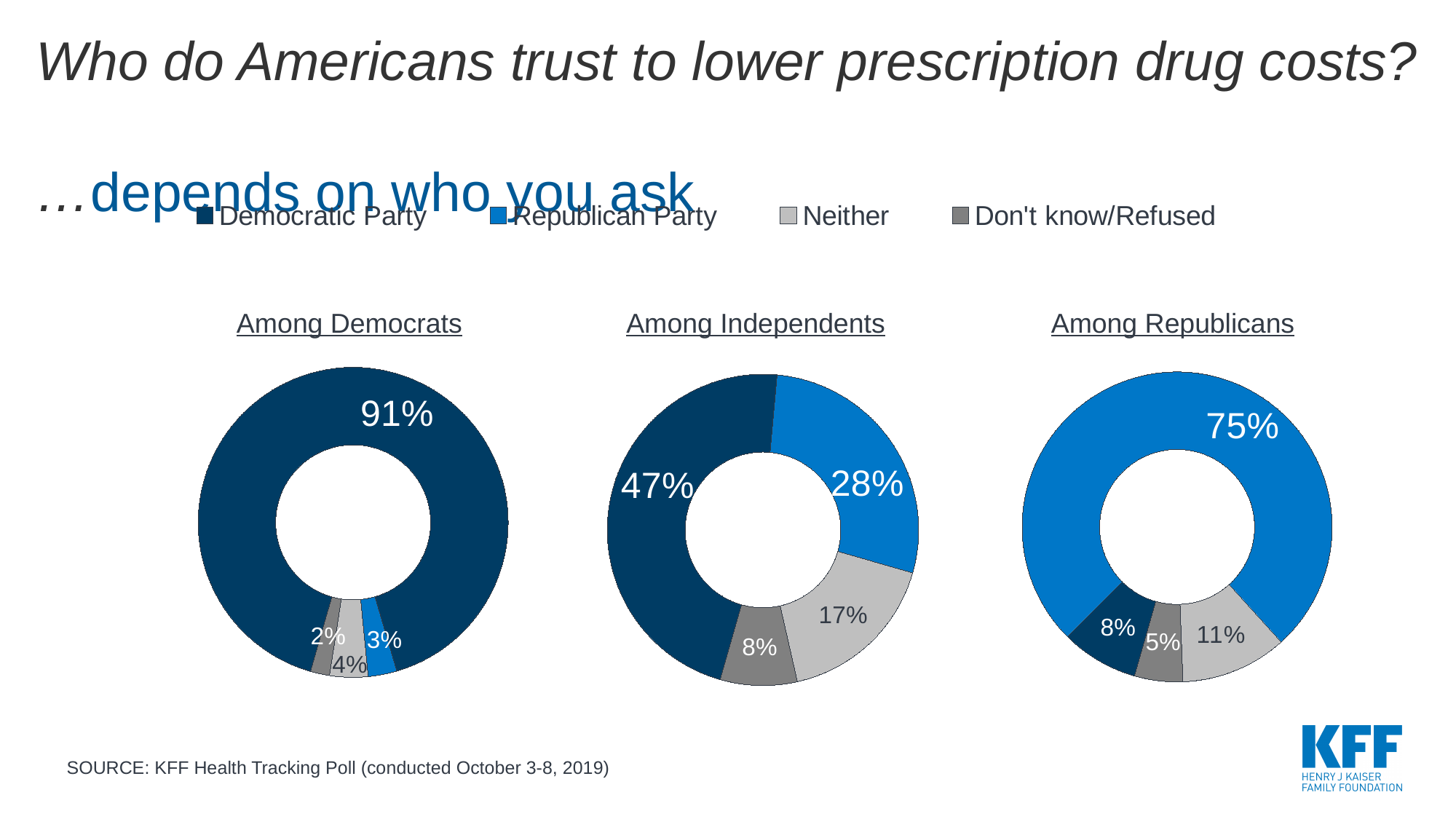
In the 'Among Republicans' chart, what share answered Don't know/Refused? 5% In the 'Among Independents' chart, which response has the largest share? Democratic Party In the 'Among Democrats' chart, which response has the smallest share? Don't know/Refused In the 'Among Republicans' chart, what share trusts the Republican Party? 75% What kind of chart is used on this slide? Donut (pie) chart In the 'Among Independents' chart, what is the difference between the Democratic Party share and the Republican Party share? 19% In the 'Among Republicans' chart, which is larger: the Neither share or the Democratic Party share? Neither How many charts are shown on the slide? 3 In the 'Among Independents' chart, what share trusts the Republican Party? 28% In the 'Among Independents' chart, what share answered Neither? 17% How many entries does the legend list? 4 In the 'Among Democrats' chart, what share trusts the Democratic Party? 91%